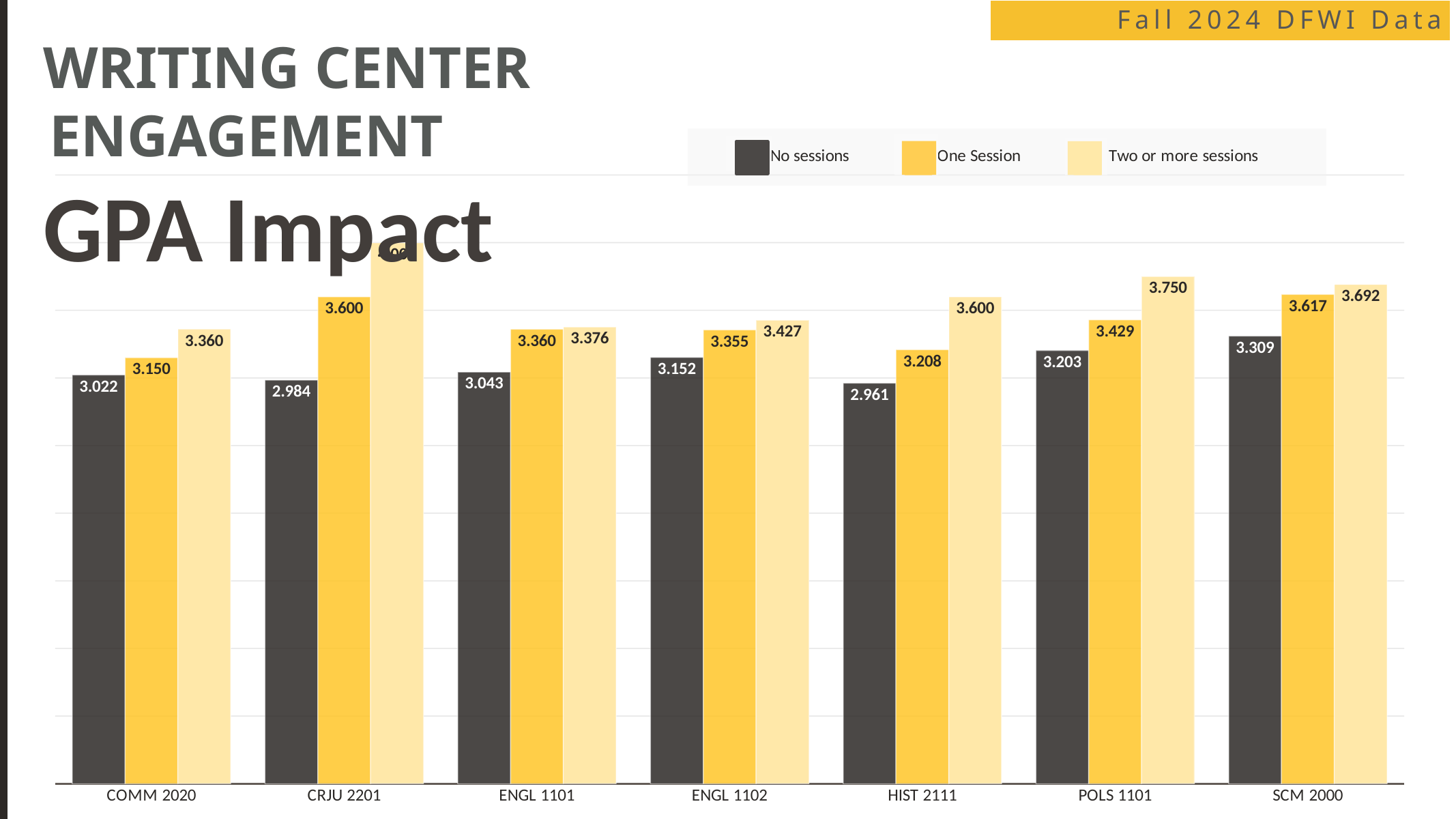
Which course has the lowest GPA for students with no sessions? HIST 2111 Which course has the highest GPA for students with no sessions? SCM 2000 What is the GPA for students with no sessions in COMM 2020? 3.022 What is the GPA for students with one session in POLS 1101? 3.429 What kind of chart is shown on the slide? Bar chart Which course has the highest GPA for students with one session? SCM 2000 How many series does the legend list? 3 In SCM 2000, what is the difference between the GPA for two or more sessions and the GPA for no sessions? 0.383 How many courses are shown on the x axis of the chart? 7 In POLS 1101, how much higher is the one-session GPA than the no-sessions GPA? 0.226 Which is larger: the one-session GPA for ENGL 1101 or the one-session GPA for ENGL 1102? ENGL 1101 What is the GPA for students with two or more sessions in HIST 2111? 3.600